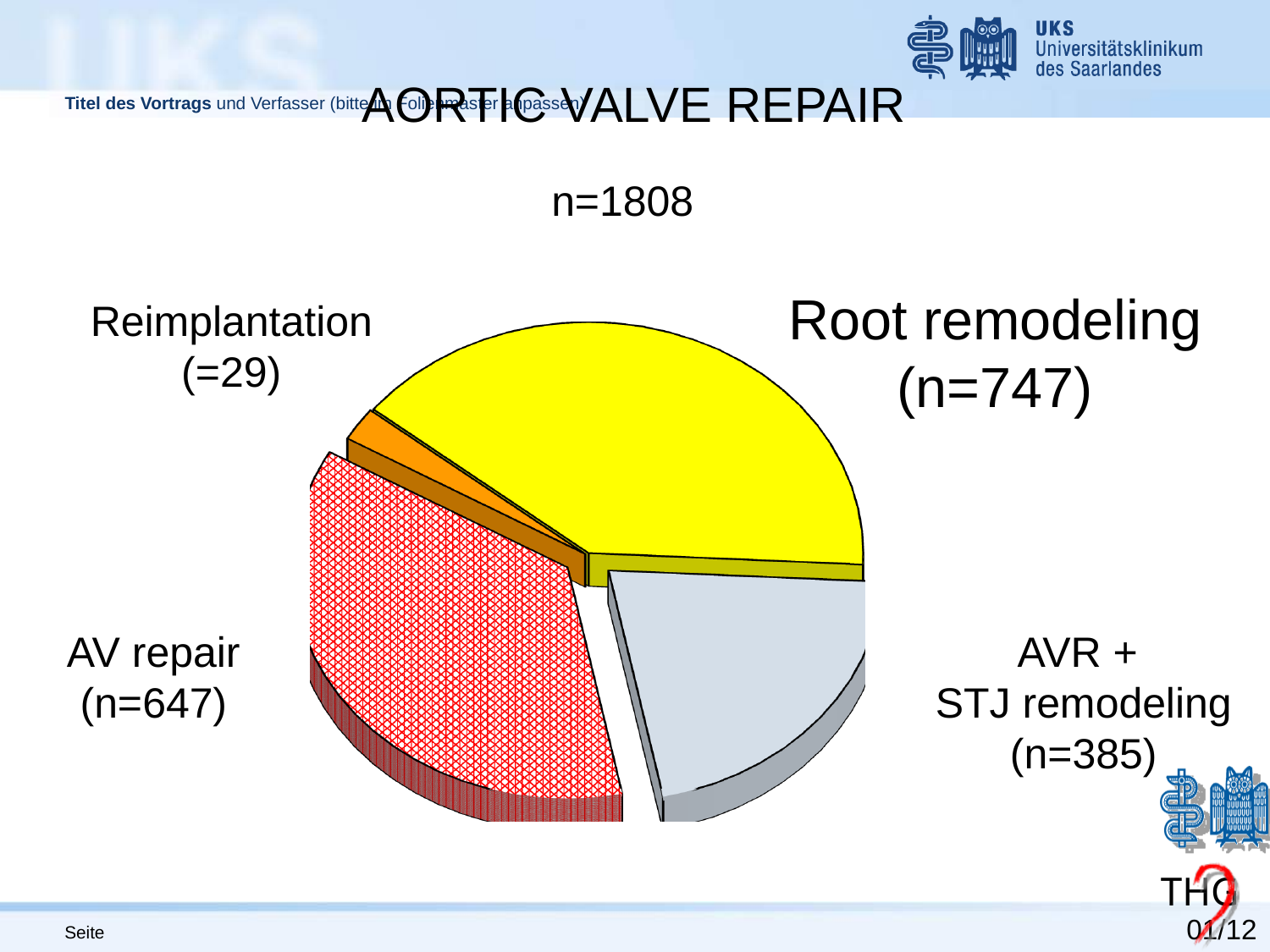
How many slices does the pie chart have? 4 What is the number of cases for AV repair? 647 What is the difference in cases between Root remodeling and AV repair? 100 What is the total number of cases (n) shown for the pie chart? 1808 What is the number of cases for Root remodeling? 747 What is the number of cases for AVR + STJ remodeling? 385 What colour is the Root remodeling slice? yellow Which category has the largest slice of the pie? Root remodeling Which category has the smallest slice of the pie? Reimplantation What is the number of cases for Reimplantation? 29 Which has more cases, AV repair or AVR + STJ remodeling? AV repair What kind of chart is shown on the slide? pie chart